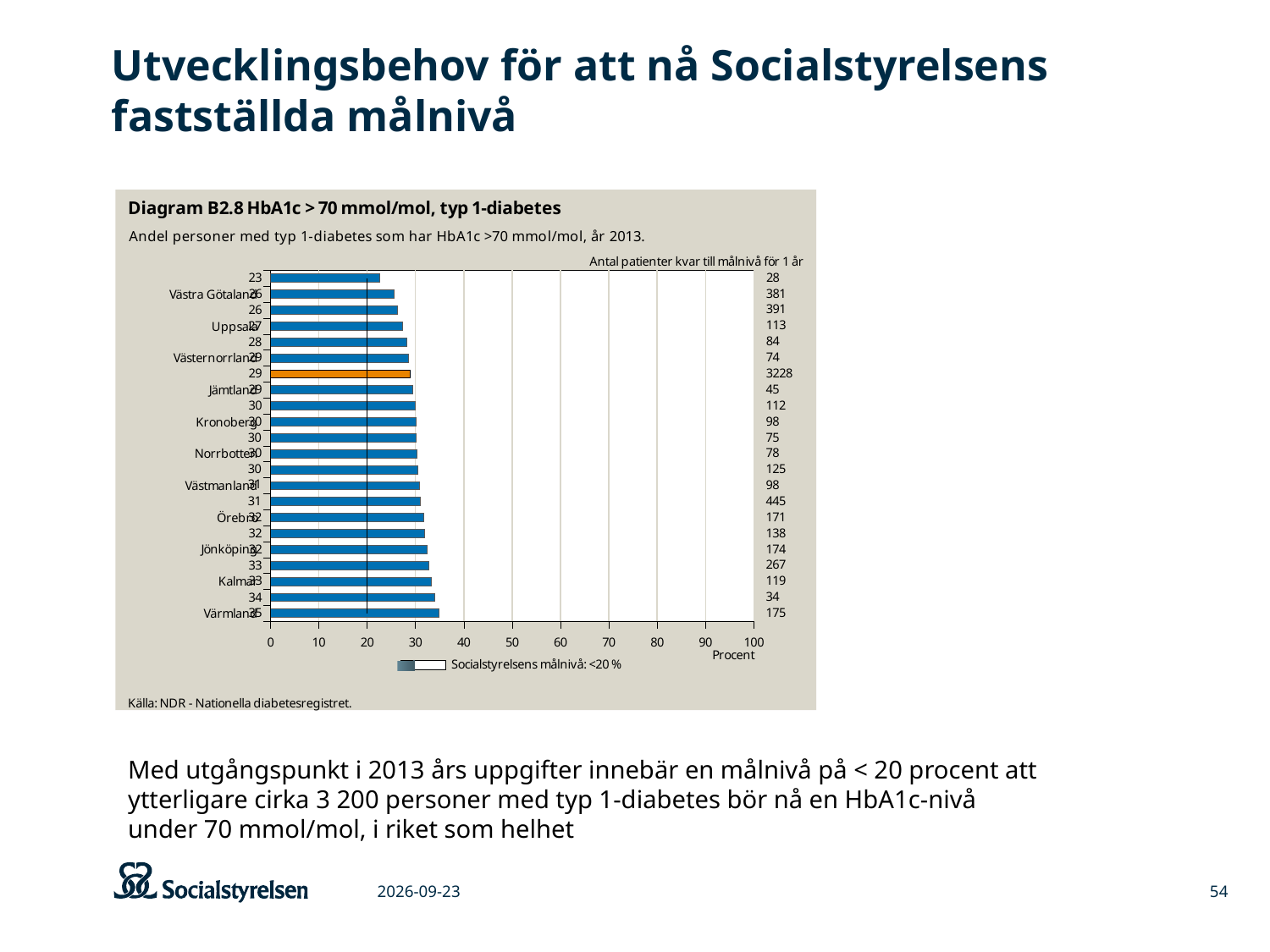
Which has a higher percentage, Örebro or Västra Götaland? Örebro What target level does the legend state for Socialstyrelsen? <20 % What kind of chart is shown on the slide? bar chart What percentage is shown for Värmland? 35 What percentage is shown for Kalmar? 33 How many bars are plotted in the chart? 22 How many patients remain to reach the target level for Värmland, according to the right-hand column? 175 What percentage is shown for Uppsala? 27 What is the title of the diagram? Diagram B2.8 HbA1c > 70 mmol/mol, typ 1-diabetes Which labelled region has the highest percentage in the chart? Värmland What is the difference in percentage between Värmland and Västra Götaland? 9 Is the value for Västra Götaland greater or less than 30? less